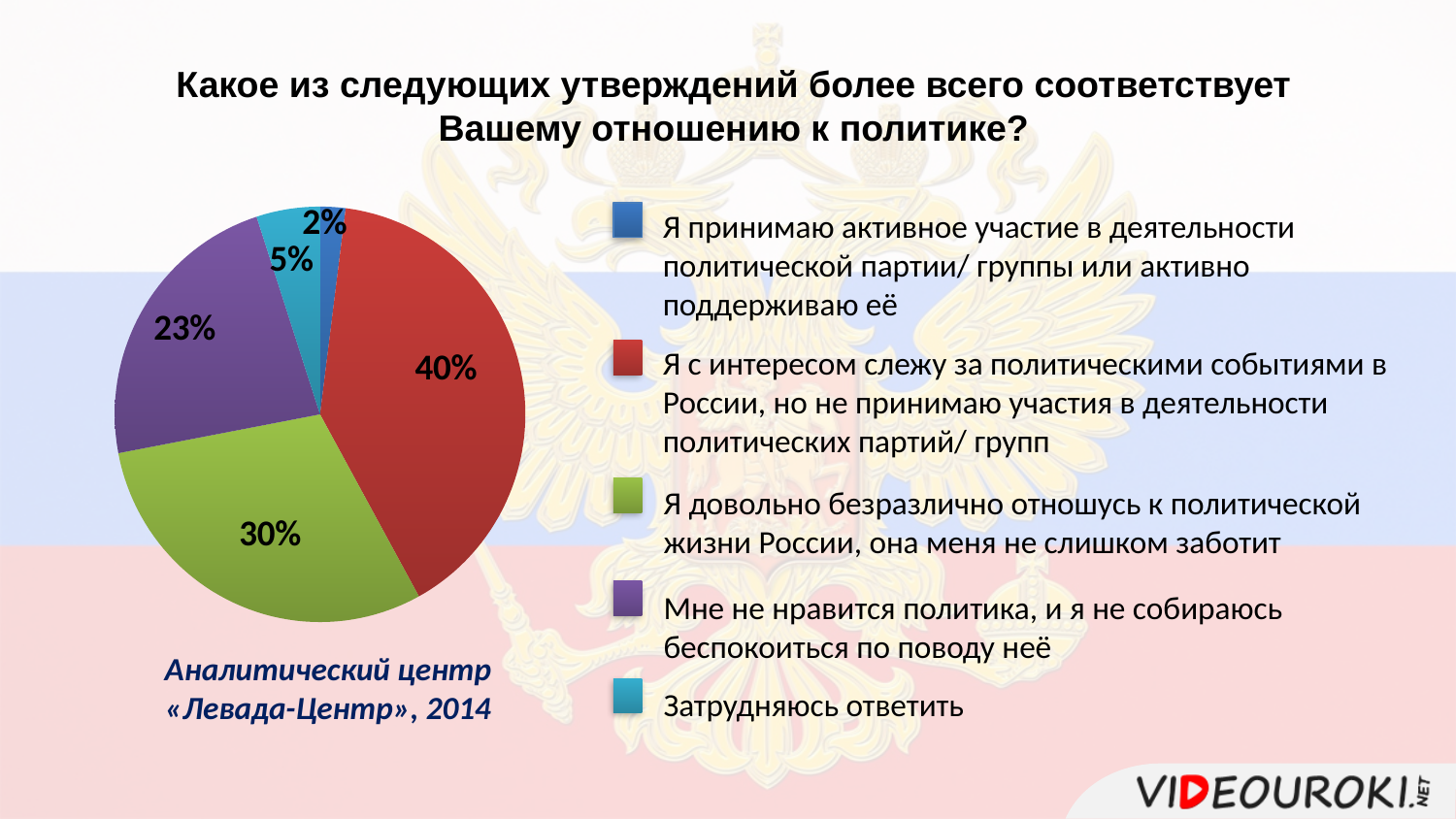
Which response has the smallest share of the pie? Я принимаю активное участие в деятельности политической партии/ группы или активно поддерживаю её What share of respondents answered "Затрудняюсь ответить"? 5% Which colour represents "Затрудняюсь ответить" in the pie chart? teal (light blue) What share of respondents chose "Я довольно безразлично отношусь к политической жизни России, она меня не слишком заботит"? 30% What share of respondents chose "Мне не нравится политика, и я не собираюсь беспокоиться по поводу неё"? 23% Which response has the largest share of the pie? Я с интересом слежу за политическими событиями в России, но не принимаю участия в деятельности политических партий/ групп What is the difference in percentage points between the 40% slice and the 23% slice? 17 What share of respondents chose "Я принимаю активное участие в деятельности политической партии/ группы или активно поддерживаю её"? 2% What share of respondents chose "Я с интересом слежу за политическими событиями в России, но не принимаю участия в деятельности политических партий/ групп"? 40% How many slices does the pie chart have? 5 What kind of chart is shown on the slide? pie chart How many entries does the legend list? 5